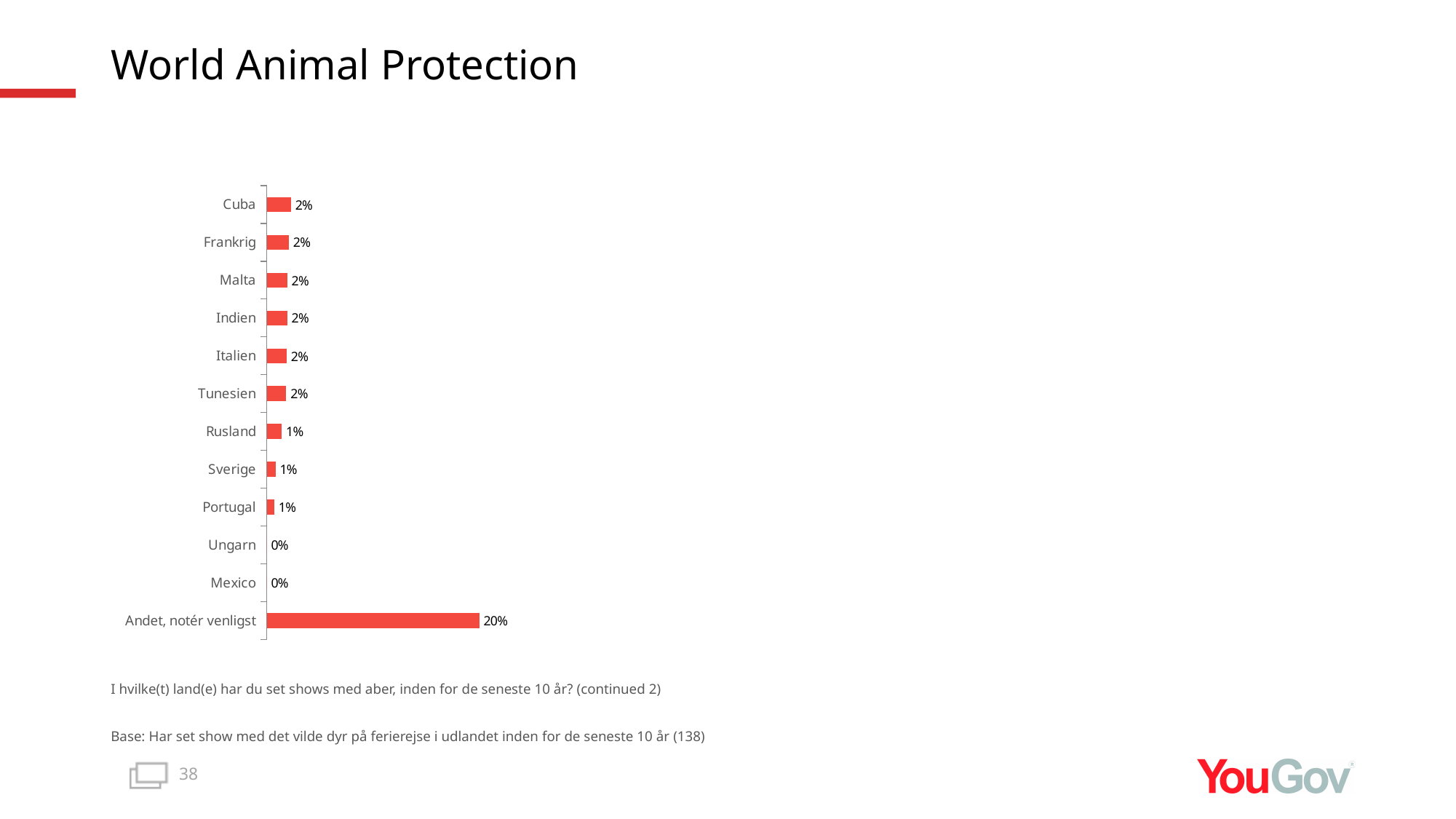
What is the difference between the value for Andet, notér venligst and the value for Italien? 18% What is the value for Andet, notér venligst? 20% What is the value for Cuba? 2% Which is larger, the value for Malta or the value for Sverige? Malta What is the difference between the value for Frankrig and the value for Portugal? 1% What kind of chart is shown on the slide? bar chart What is the value for Rusland? 1% How many categories are plotted in the chart? 12 What is the value for Tunesien? 2% What colour are the bars in the chart? red Which category has the highest value in the chart? Andet, notér venligst What is the value for Mexico? 0%